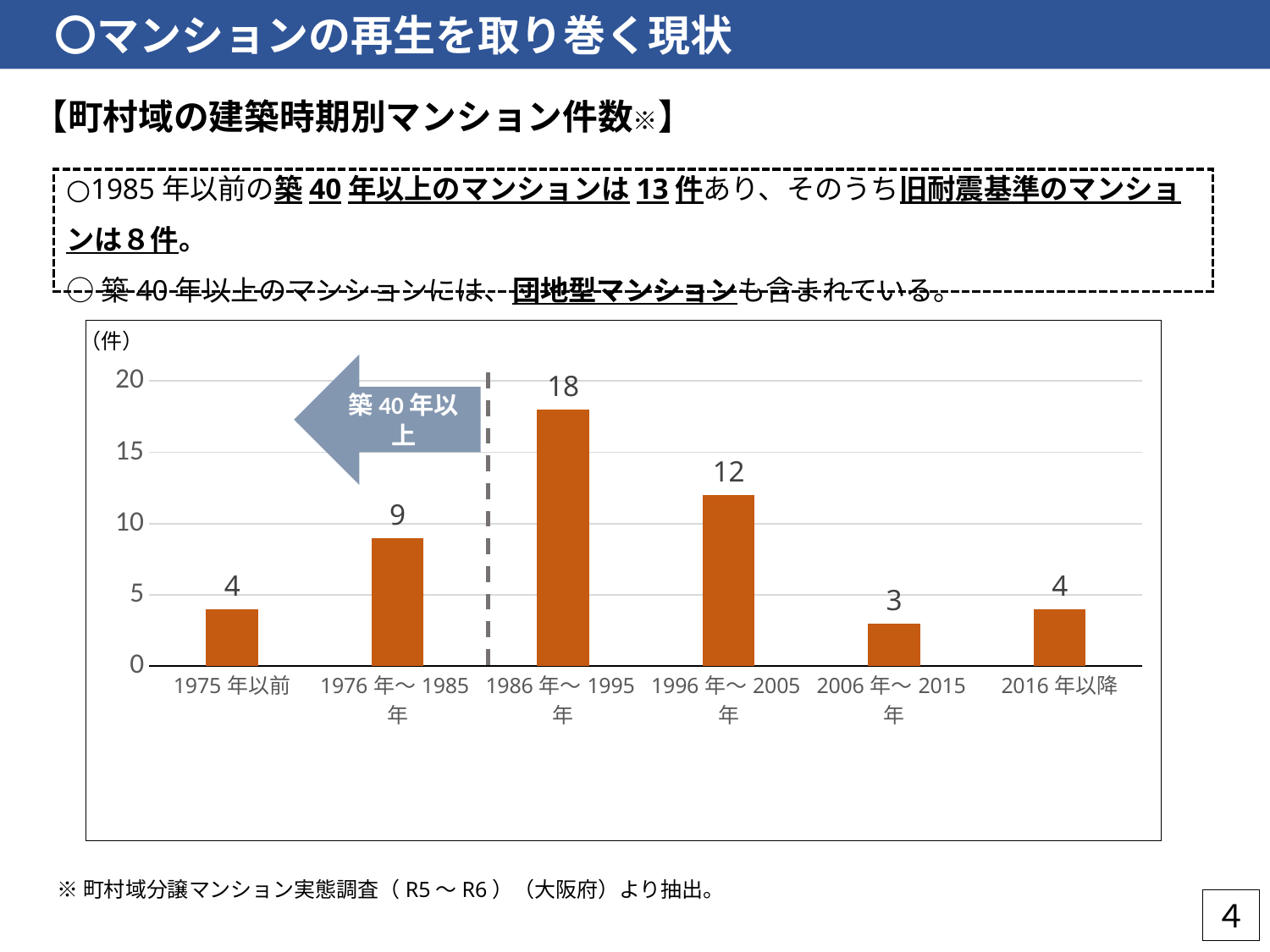
What kind of chart is shown on the slide? bar chart What is the value for 1976年～1985年? 9 What unit label is shown at the top of the vertical axis? (件) How many categories are shown on the x axis? 6 What is the total of the values for 1975年以前 and 1976年～1985年? 13 What is the value for 1986年～1995年? 18 What is the value for 2006年～2015年? 3 What is the difference between the values for 1986年～1995年 and 1996年～2005年? 6 Which is larger, the value for 1976年～1985年 or the value for 2016年以降? 1976年～1985年 Which category has the highest value? 1986年～1995年 Which category has the lowest value? 2006年～2015年 Is the value for 1996年～2005年 greater or less than 10? greater